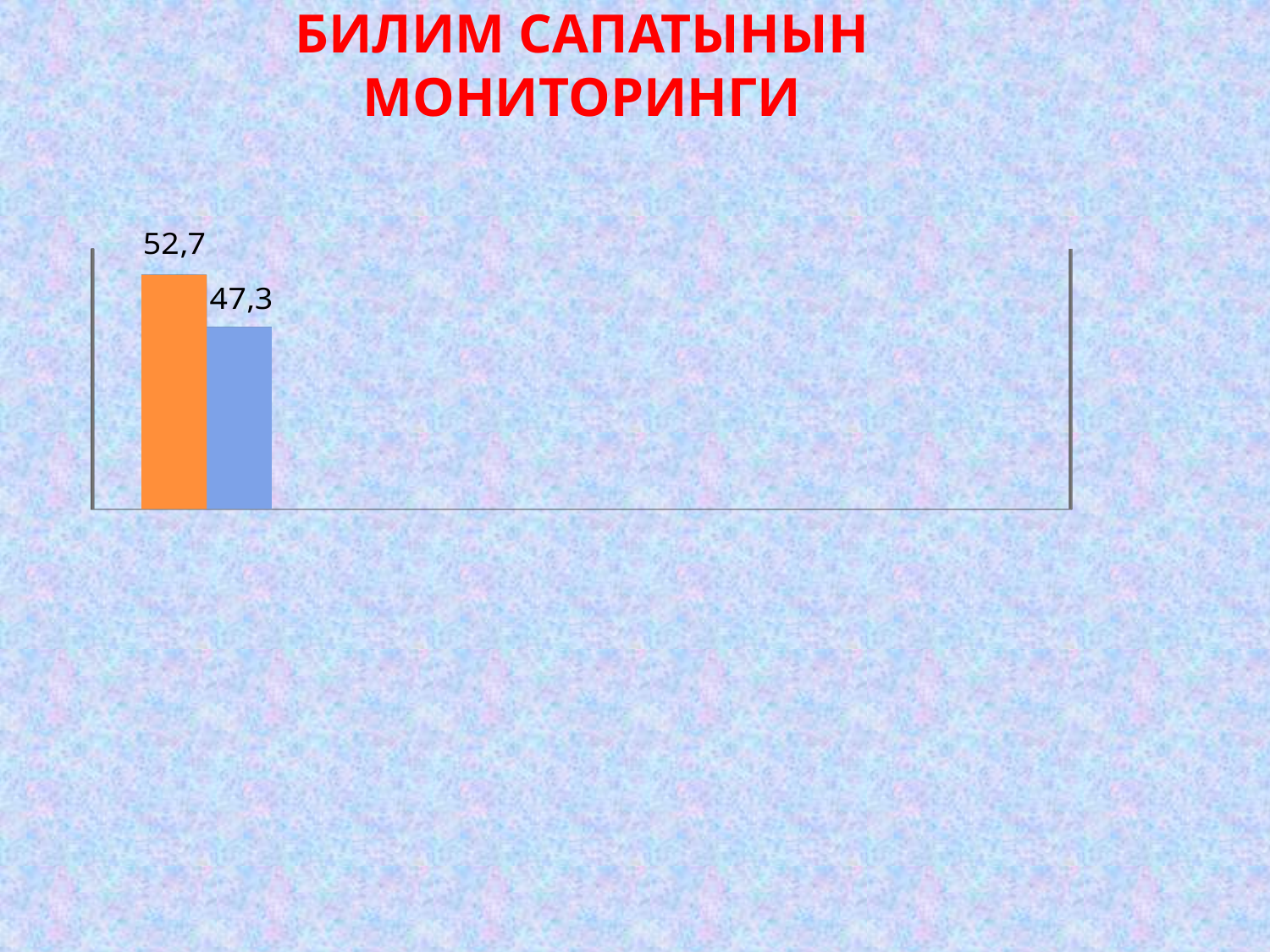
Which bar has the higher value, the orange one or the blue one? the orange bar How many bars are plotted in the chart? 2 What is the difference between the values of the orange bar and the blue bar? 5,4 What kind of chart is shown on the slide? bar chart Which bar has the lower value, the orange one or the blue one? the blue bar What value is shown on the blue bar? 47,3 What is the title shown at the top of the slide? БИЛИМ САПАТЫНЫН МОНИТОРИНГИ What value is shown on the orange bar? 52,7 Is the value of the blue bar larger or smaller than the value of the orange bar? smaller What colour is the bar with the value 47,3? blue